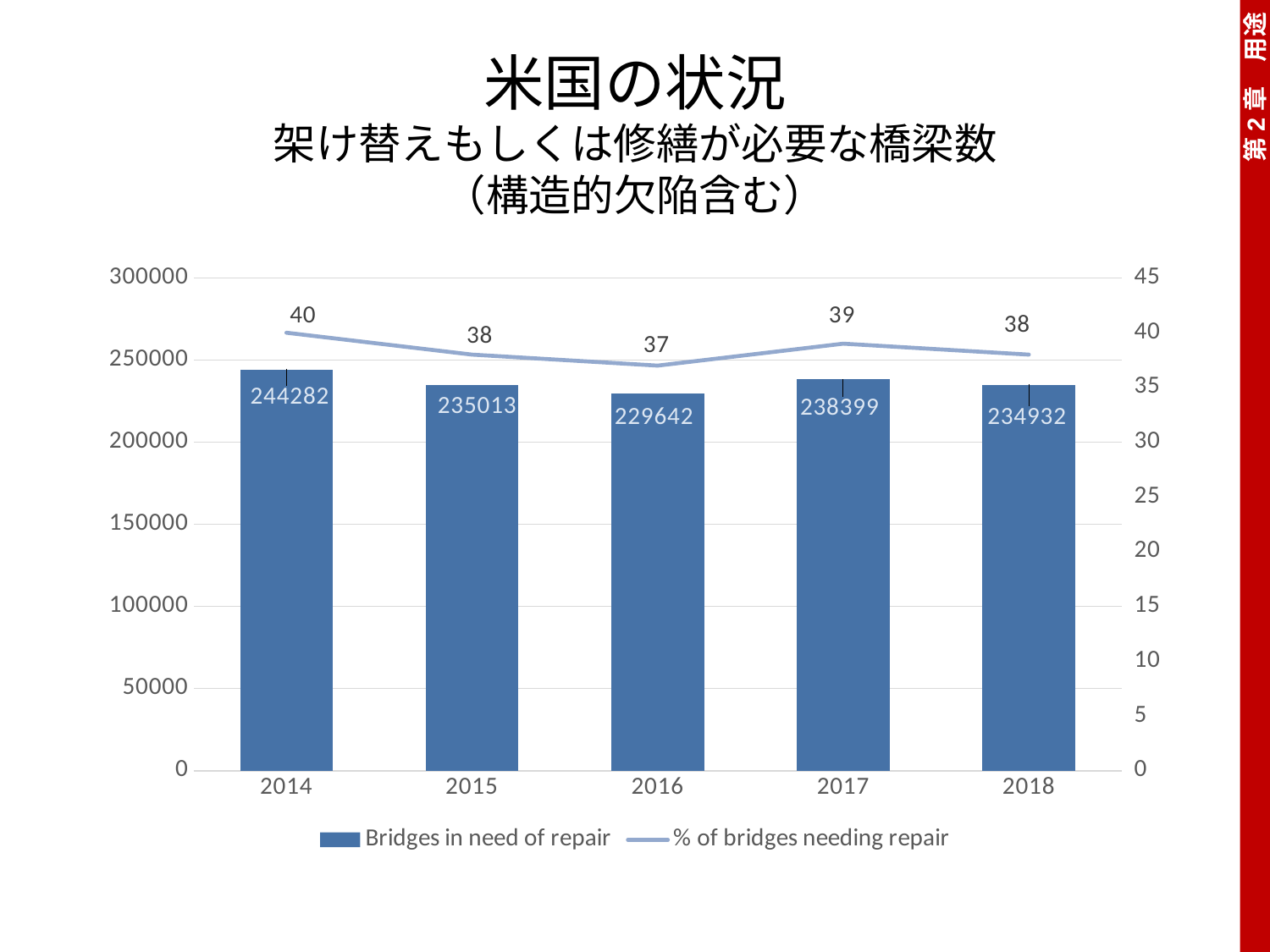
Which year has the lowest number of Bridges in need of repair? 2016 What is the difference in Bridges in need of repair between 2014 and 2016? 14640 Which year has the highest number of Bridges in need of repair? 2014 What is the % of bridges needing repair for 2014? 40 What is the value of Bridges in need of repair for 2014? 244282 How many years are shown on the x axis? 5 Which year has a higher number of Bridges in need of repair, 2015 or 2017? 2017 What is the value of Bridges in need of repair for 2016? 229642 What is the % of bridges needing repair for 2017? 39 Which year has the lowest % of bridges needing repair? 2016 What kind of chart is used for the Bridges in need of repair series? Bar chart How many series does the legend list? 2